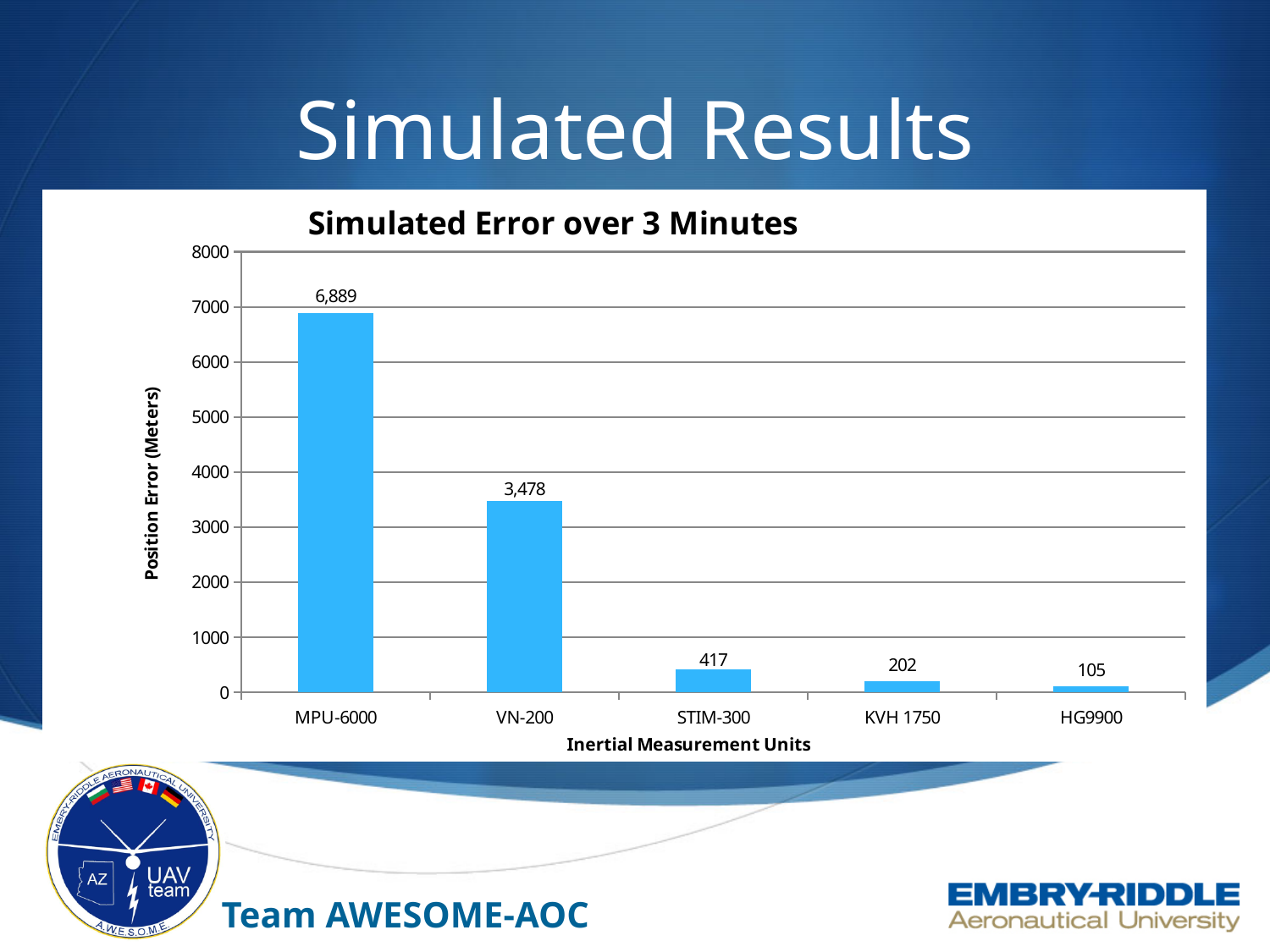
What is the position error for the STIM-300? 417 Which inertial measurement unit has the lowest simulated position error? HG9900 What is the position error for the HG9900? 105 What is the title of the chart? Simulated Error over 3 Minutes How many inertial measurement units are shown on the chart? 5 What is the position error for the VN-200? 3,478 Which has a larger position error, the STIM-300 or the KVH 1750? STIM-300 What is the difference in position error between the MPU-6000 and the VN-200? 3,411 Which inertial measurement unit has the highest simulated position error? MPU-6000 What is the difference in position error between the KVH 1750 and the HG9900? 97 What is the position error for the MPU-6000? 6,889 What kind of chart is shown on the slide? Bar chart